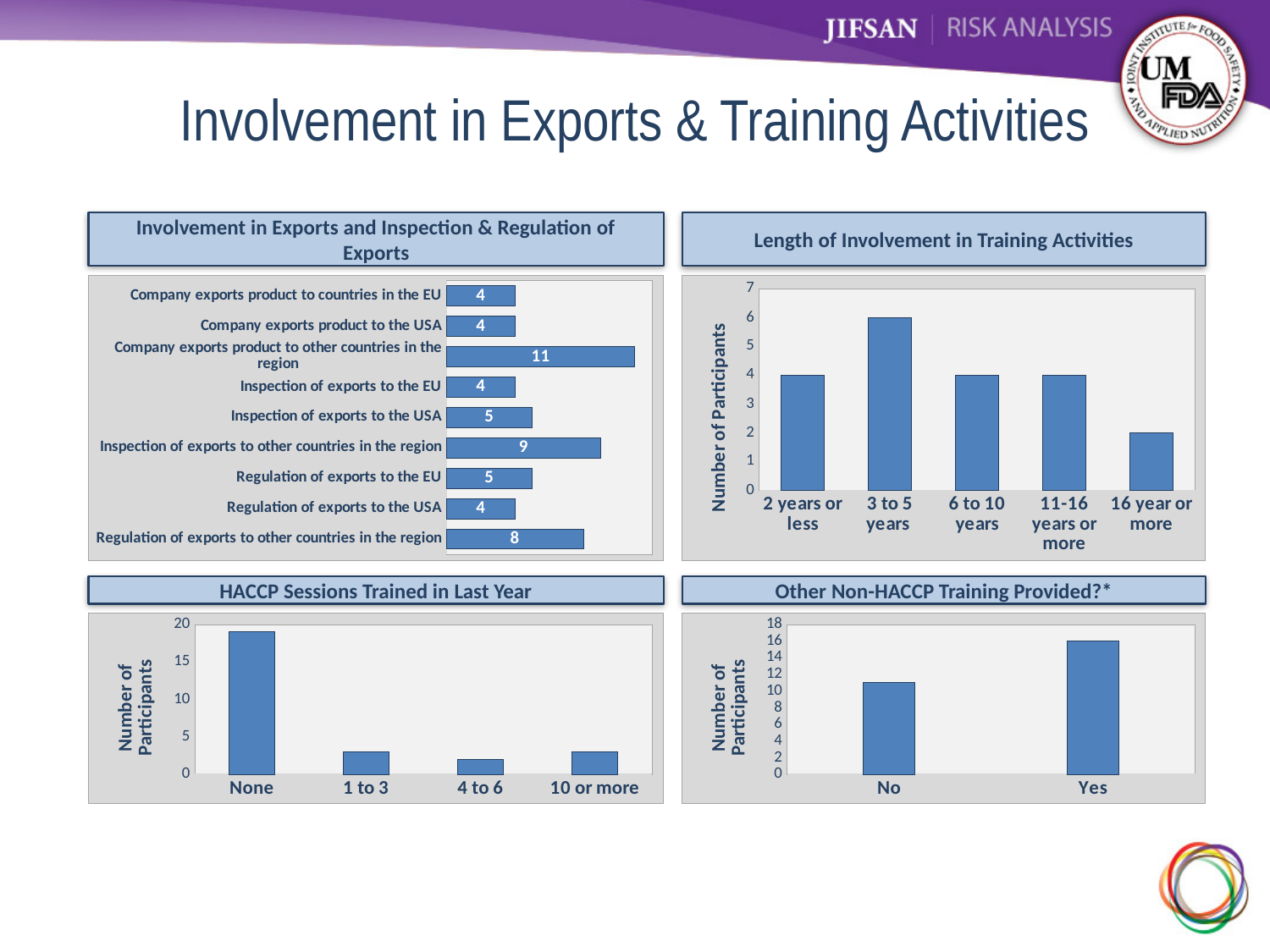
In the 'Involvement in Exports and Inspection & Regulation of Exports' chart, what is the value for 'Company exports product to other countries in the region'? 11 How many categories are shown in the 'Involvement in Exports and Inspection & Regulation of Exports' chart? 9 In the 'Length of Involvement in Training Activities' chart, which category has the lowest number of participants? 16 year or more In the 'Other Non-HACCP Training Provided?*' chart, which is larger, 'No' or 'Yes'? Yes What type of chart is the 'Involvement in Exports and Inspection & Regulation of Exports' chart? Bar chart How many categories are shown in the 'Length of Involvement in Training Activities' chart? 5 In the 'Involvement in Exports and Inspection & Regulation of Exports' chart, what is the difference between 'Inspection of exports to other countries in the region' and 'Regulation of exports to other countries in the region'? 1 In the 'Other Non-HACCP Training Provided?*' chart, is the value for 'No' greater or less than 10? greater In the 'Length of Involvement in Training Activities' chart, which category has the highest number of participants? 3 to 5 years In the 'HACCP Sessions Trained in Last Year' chart, is the value for 'None' greater or less than 15? greater In the 'Involvement in Exports and Inspection & Regulation of Exports' chart, which category has the highest value? Company exports product to other countries in the region In the 'Involvement in Exports and Inspection & Regulation of Exports' chart, what is the value for 'Inspection of exports to the USA'? 5